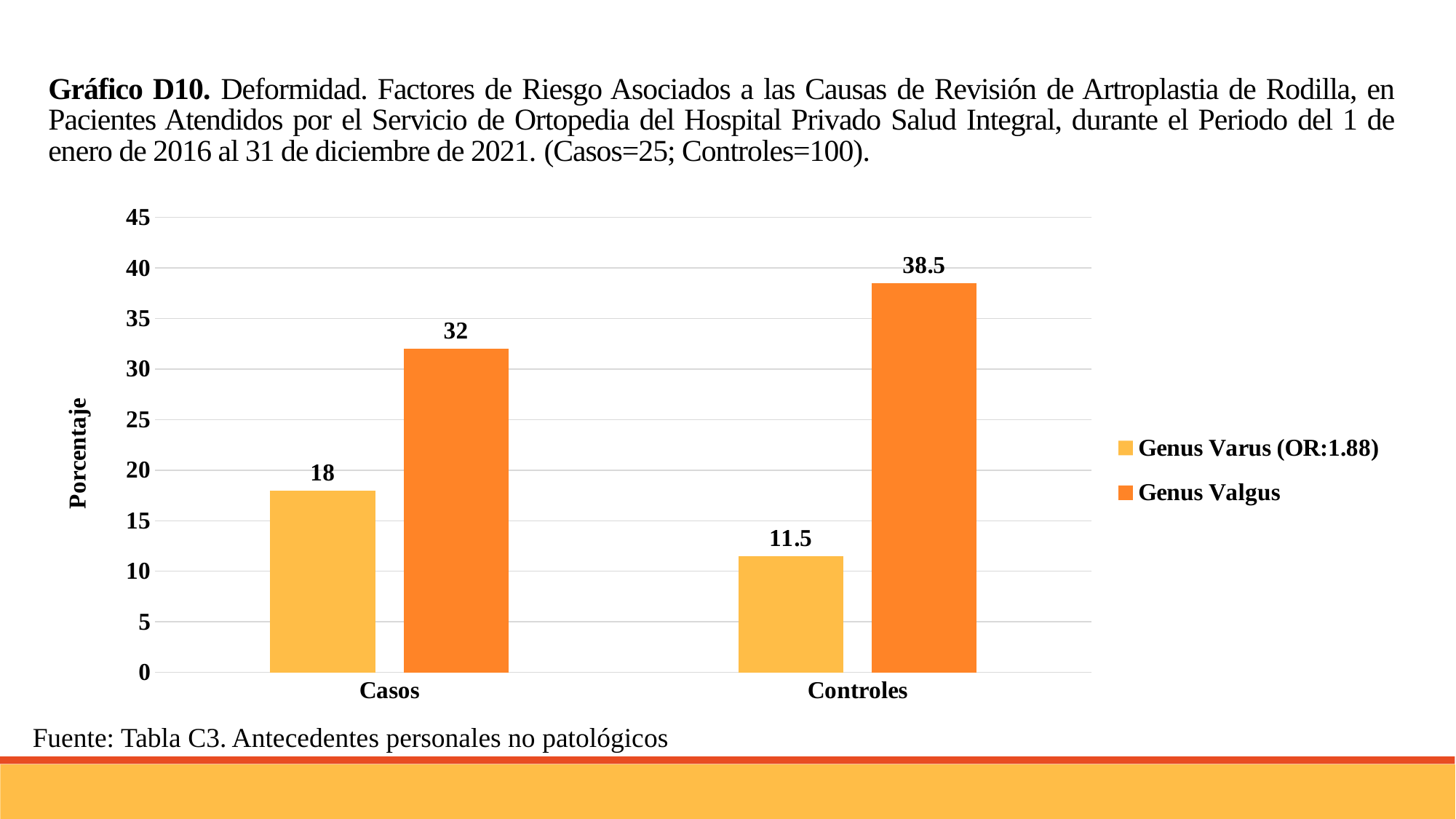
How many categories are shown on the x axis? 2 What is the value for Genus Valgus in the Casos category? 32 What is the label of the y axis? Porcentaje Which bar has the lowest value on the chart? Genus Varus, Controles What is the value for Genus Valgus in the Controles category? 38.5 What is the difference between the Genus Valgus values for Controles and Casos? 6.5 What is the value for Genus Varus in the Controles category? 11.5 How many series does the legend list? 2 Which bar has the highest value on the chart? Genus Valgus, Controles What kind of chart is shown on the slide? Bar chart Which is larger: Genus Varus for Casos or Genus Varus for Controles? Genus Varus for Casos What is the value for Genus Varus in the Casos category? 18